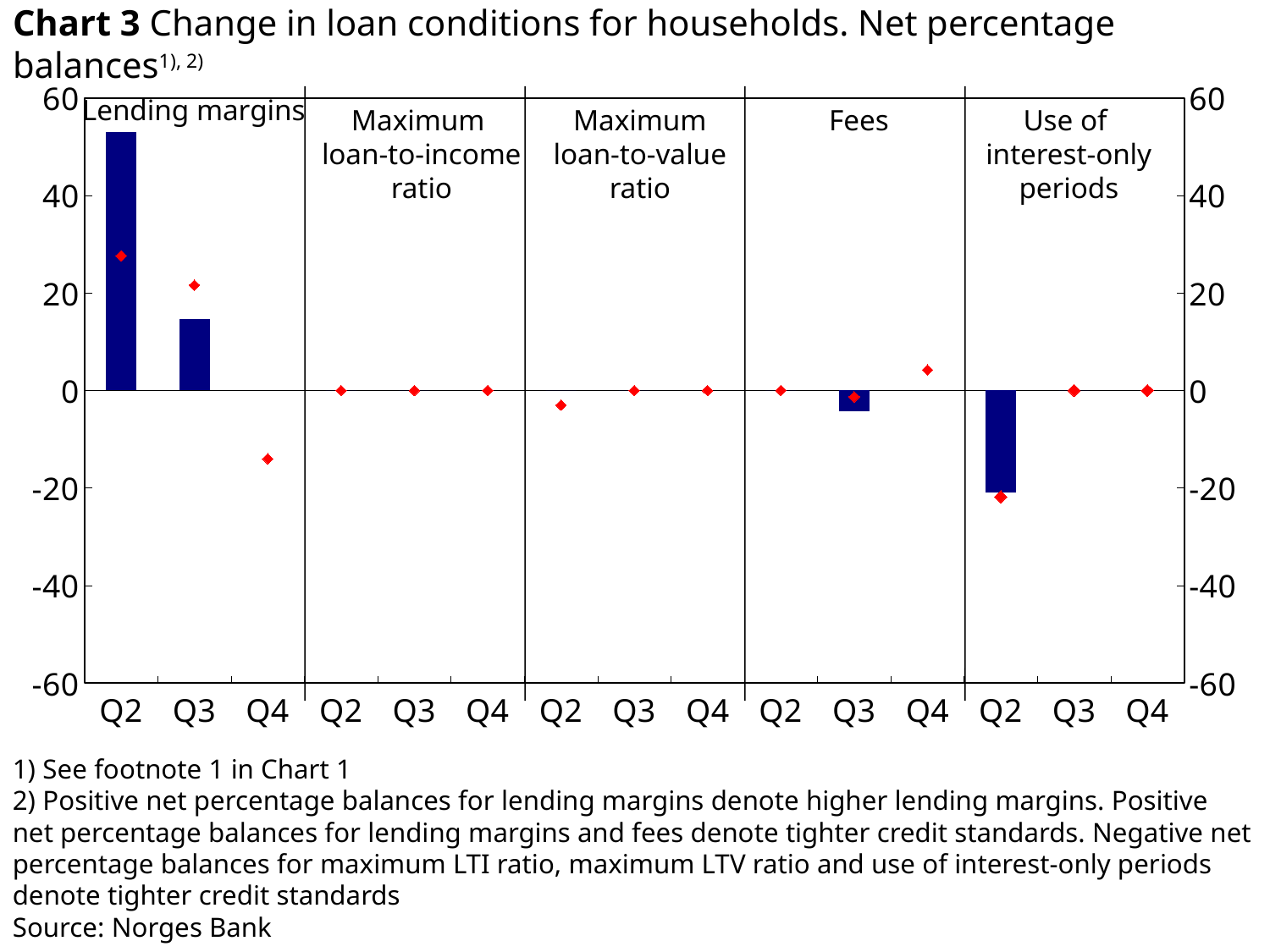
Is the Q2 bar for Lending margins greater or less than 40? greater Which panel and quarter has the tallest bar in Chart 3? Lending margins, Q2 Which panel and quarter has the lowest (most negative) bar in Chart 3? Use of interest-only periods, Q2 Do the red markers in the Lending margins panel rise or fall from Q2 to Q4? Fall Is the Q2 bar for Use of interest-only periods greater or less than -10? less How many loan-condition panels does Chart 3 show? 5 What is the source given for Chart 3? Norges Bank Is the Q3 bar for Lending margins greater or less than 20? less How many quarters are shown in each panel of Chart 3? 3 What kind of chart is Chart 3? Combination bar and marker chart (bars with red diamond markers) In the Lending margins panel, which bar is larger, Q2 or Q3? Q2